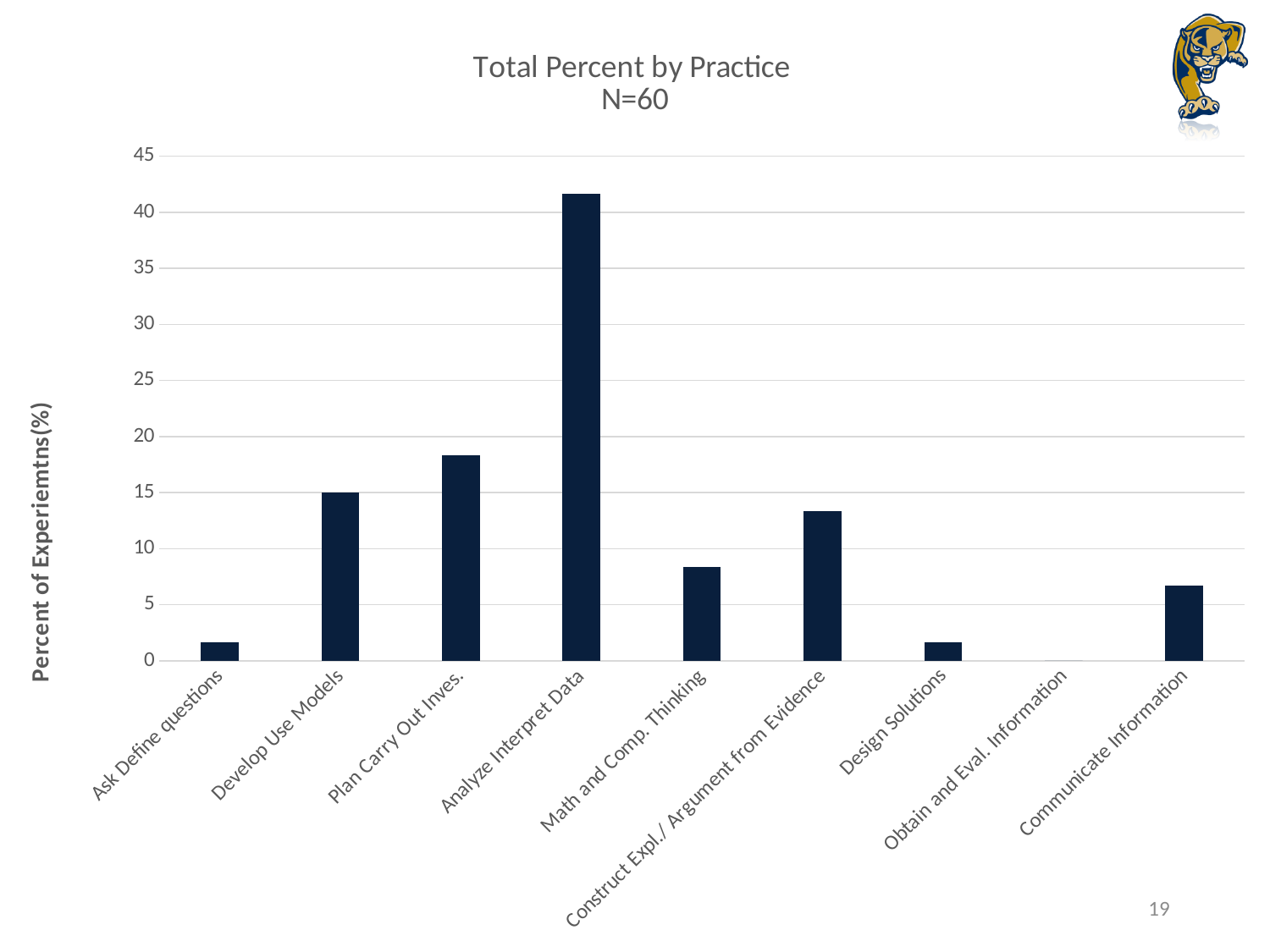
Is the value for Math and Comp. Thinking greater or less than 5? greater What is the title of the chart? Total Percent by Practice N=60 How many practices (categories) are shown on the x axis? 9 What is the label on the vertical axis? Percent of Experiemtns(%) Which practice has the lowest percent of experiments? Obtain and Eval. Information Which is larger, the value for Develop Use Models or the value for Construct Expl./ Argument from Evidence? Develop Use Models Which is larger, the value for Plan Carry Out Inves. or the value for Math and Comp. Thinking? Plan Carry Out Inves. Is the value for Plan Carry Out Inves. greater or less than 20? less Is the value for Analyze Interpret Data greater or less than 40? greater What kind of chart is shown on the slide? bar chart Which practice has the highest percent of experiments? Analyze Interpret Data